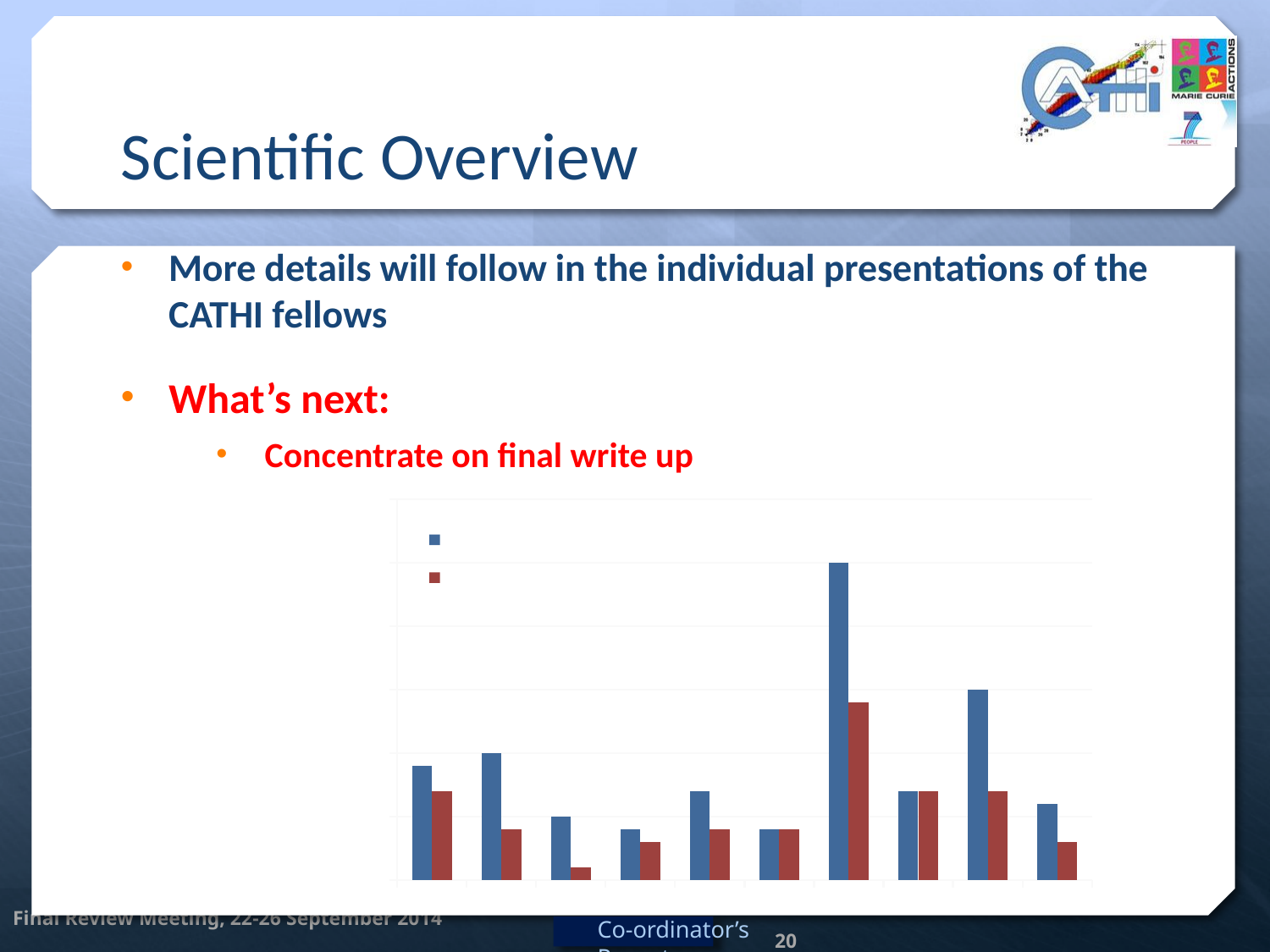
Does the chart display any data labels on its bars? No Counting from the left, which group of bars contains the tallest bar in the chart? the seventh group What kind of chart is shown on the slide? bar chart What colours are the two series in the chart? blue and red How many series does the chart's legend list? 2 In the seventh group of bars from the left, which bar is taller, the blue one or the red one? the blue one Counting from the left, which group of bars contains the shortest red bar in the chart? the third group How many groups of bars are plotted along the x axis of the chart? 10